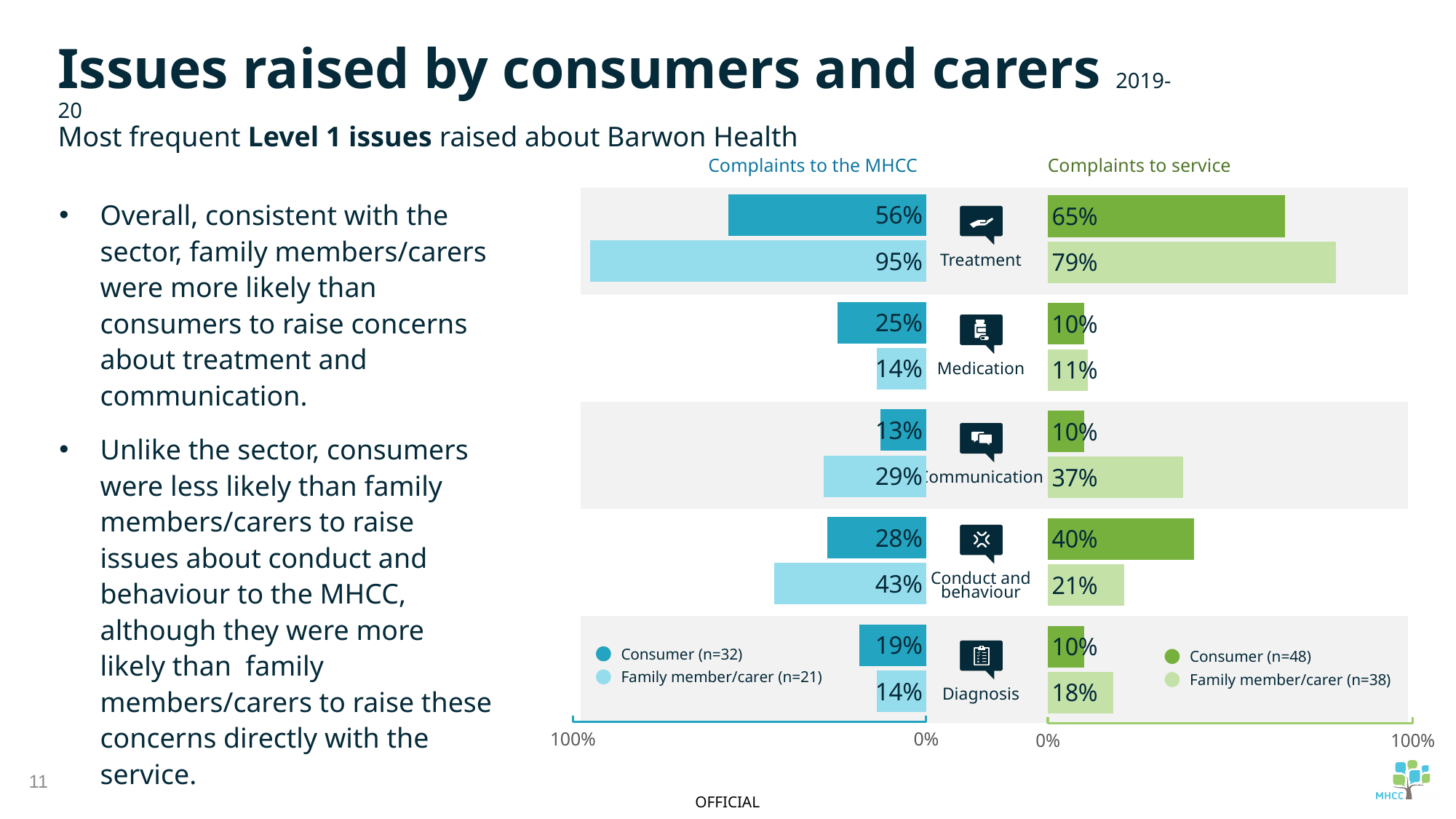
In the 'Complaints to service' chart, which category has the lowest Family member/carer value? Medication In the 'Complaints to service' chart, what is the difference between the Consumer and Family member/carer values for Conduct and behaviour? 19% In the 'Complaints to service' chart, what is the Family member/carer value for Diagnosis? 18% How many series does the legend of the 'Complaints to the MHCC' chart list? 2 In the 'Complaints to the MHCC' chart, what is the Consumer value for Communication? 13% In the 'Complaints to the MHCC' chart, what percentage of family members/carers raised issues about Treatment? 95% In the 'Complaints to the MHCC' chart, which is larger for Medication: the Consumer value or the Family member/carer value? Consumer How many issue categories are shown in the 'Complaints to service' chart? 5 In the 'Complaints to the MHCC' chart, what is the difference between the Family member/carer and Consumer values for Treatment? 39% In the 'Complaints to the MHCC' chart, which category has the highest Consumer value? Treatment In the 'Complaints to service' chart, what percentage of consumers raised issues about Conduct and behaviour? 40% What type of chart is the 'Complaints to service' chart? Bar chart